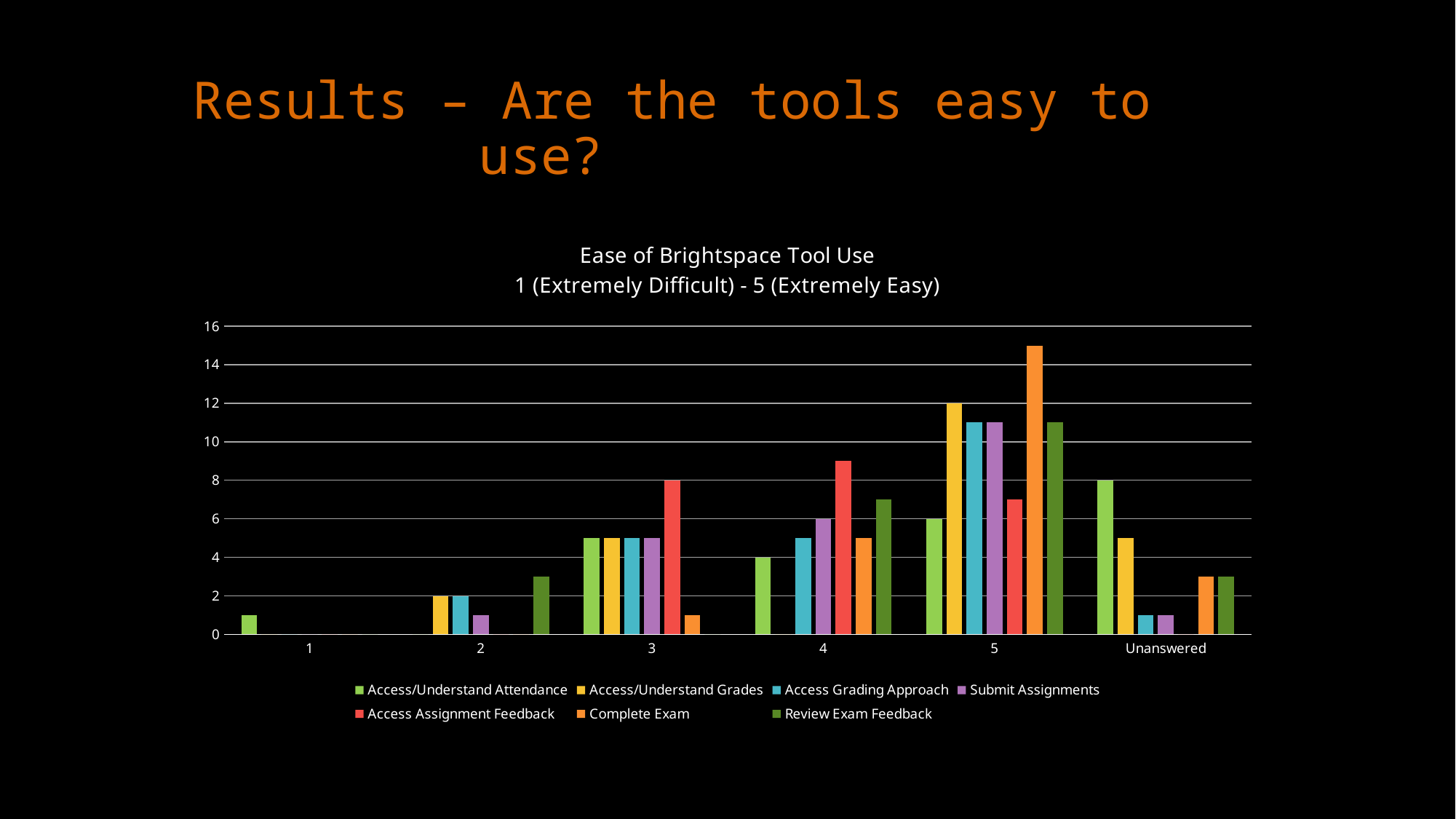
Is the value for Complete Exam at rating 5 greater or less than 14? greater What kind of chart is shown on the slide? bar chart Which series has the tallest bar in the whole chart? Complete Exam Which is larger at rating 3: Access Assignment Feedback or Complete Exam? Access Assignment Feedback Which series has the tallest bar in the Unanswered category? Access/Understand Attendance Which is larger at rating 5: Access/Understand Grades or Access Assignment Feedback? Access/Understand Grades How many series does the legend list? 7 How many categories are shown along the x axis? 6 Is the value for Access Assignment Feedback at rating 4 greater or less than 8? greater Is the value for Review Exam Feedback at rating 2 greater or less than 4? less Which series is the only one with a bar at rating 1? Access/Understand Attendance What is the title of the chart? Ease of Brightspace Tool Use 1 (Extremely Difficult) - 5 (Extremely Easy)